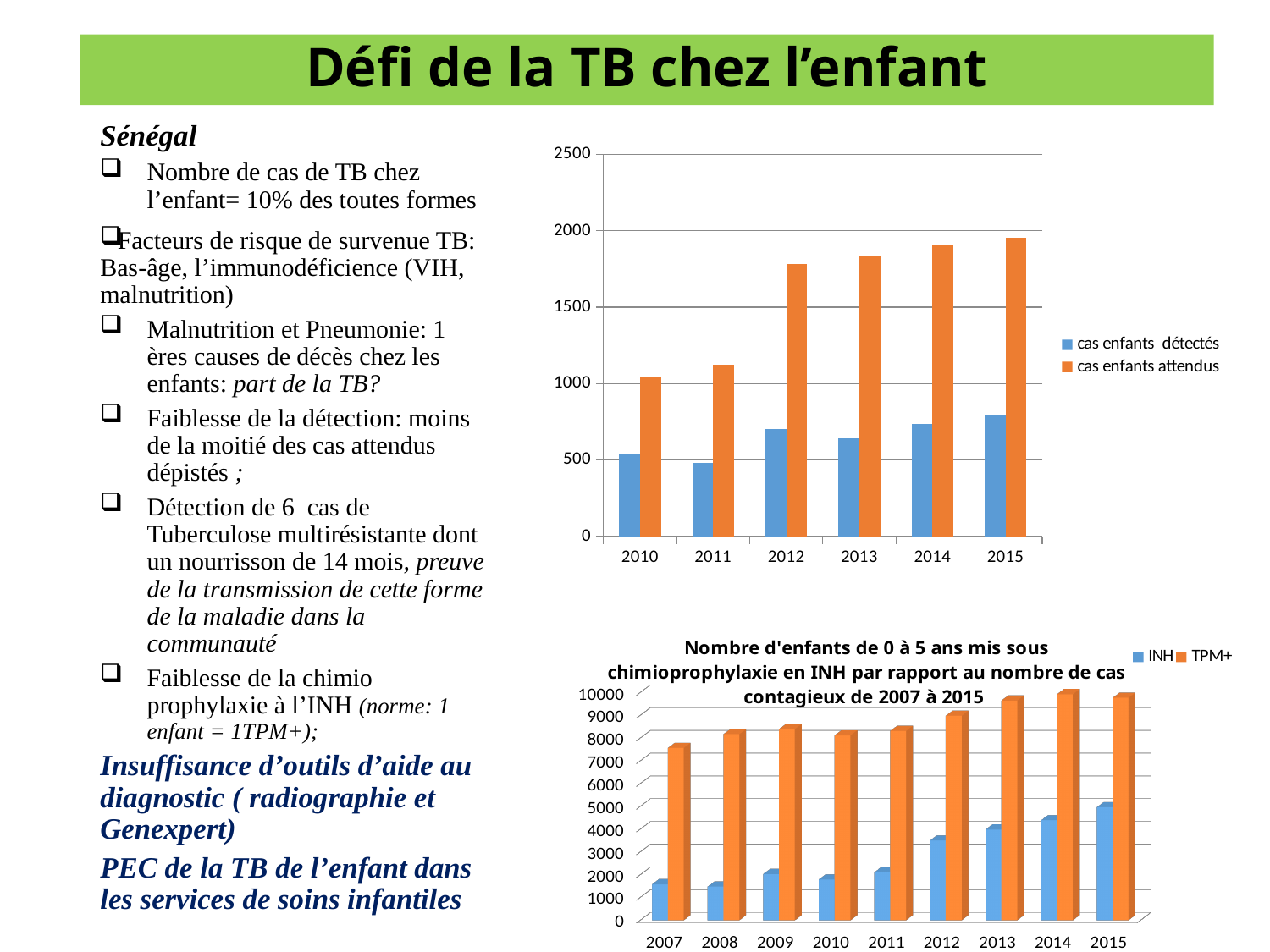
In the chart titled 'Nombre d'enfants de 0 à 5 ans mis sous chimioprophylaxie en INH...', which year has the highest INH value? 2015 How many series does the legend of the upper chart list? 2 What kind of chart is the upper chart on the slide? bar chart In the upper chart, which is larger in 2013: cas enfants détectés or cas enfants attendus? cas enfants attendus In the chart titled 'Nombre d'enfants de 0 à 5 ans mis sous chimioprophylaxie en INH...', how many years are shown on the x axis? 9 In the upper chart, which year has the highest value for cas enfants attendus? 2015 In the upper chart, is the value for cas enfants attendus in 2012 greater or less than 1500? greater In the chart titled 'Nombre d'enfants de 0 à 5 ans mis sous chimioprophylaxie en INH...', is the INH value for 2012 greater or less than 3000? greater In the chart titled 'Nombre d'enfants de 0 à 5 ans mis sous chimioprophylaxie en INH...', what colour are the TPM+ bars? orange How many years are shown on the x axis of the upper chart? 6 In the upper chart, which year has the lowest value for cas enfants détectés? 2011 In the upper chart, is the value for cas enfants détectés in 2015 greater or less than 1000? less